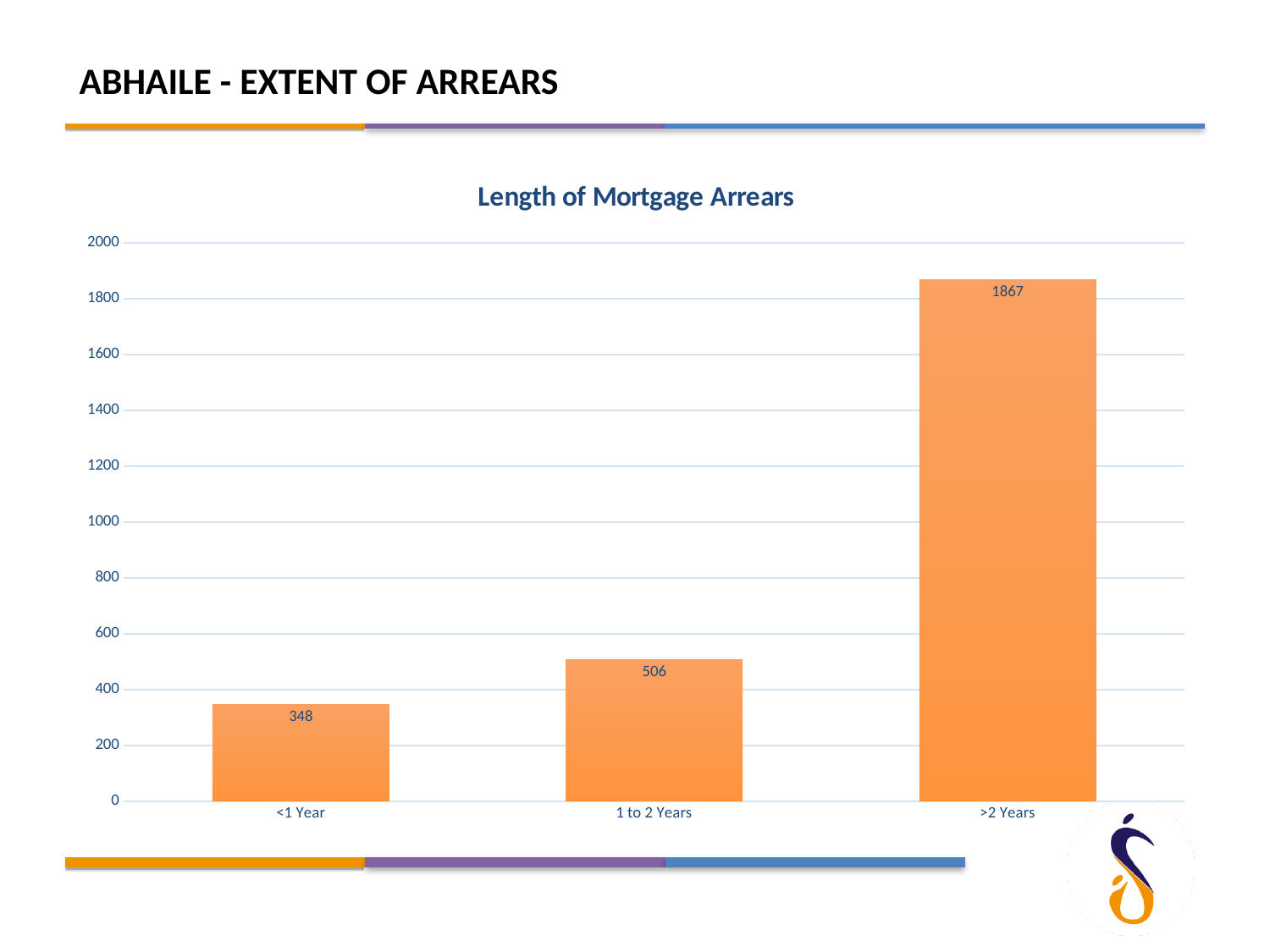
What kind of chart is shown on the slide? bar chart How many categories are shown on the x axis? 3 Which is larger, the value for <1 Year or the value for 1 to 2 Years? 1 to 2 Years What is the value for the <1 Year category? 348 Is the value for >2 Years greater or less than 1800? greater Which category has the lowest value? <1 Year What is the difference between the values for >2 Years and 1 to 2 Years? 1361 What is the title of the chart? Length of Mortgage Arrears What is the value for the 1 to 2 Years category? 506 Which category has the highest value? >2 Years What is the difference between the values for 1 to 2 Years and <1 Year? 158 What is the value for the >2 Years category? 1867